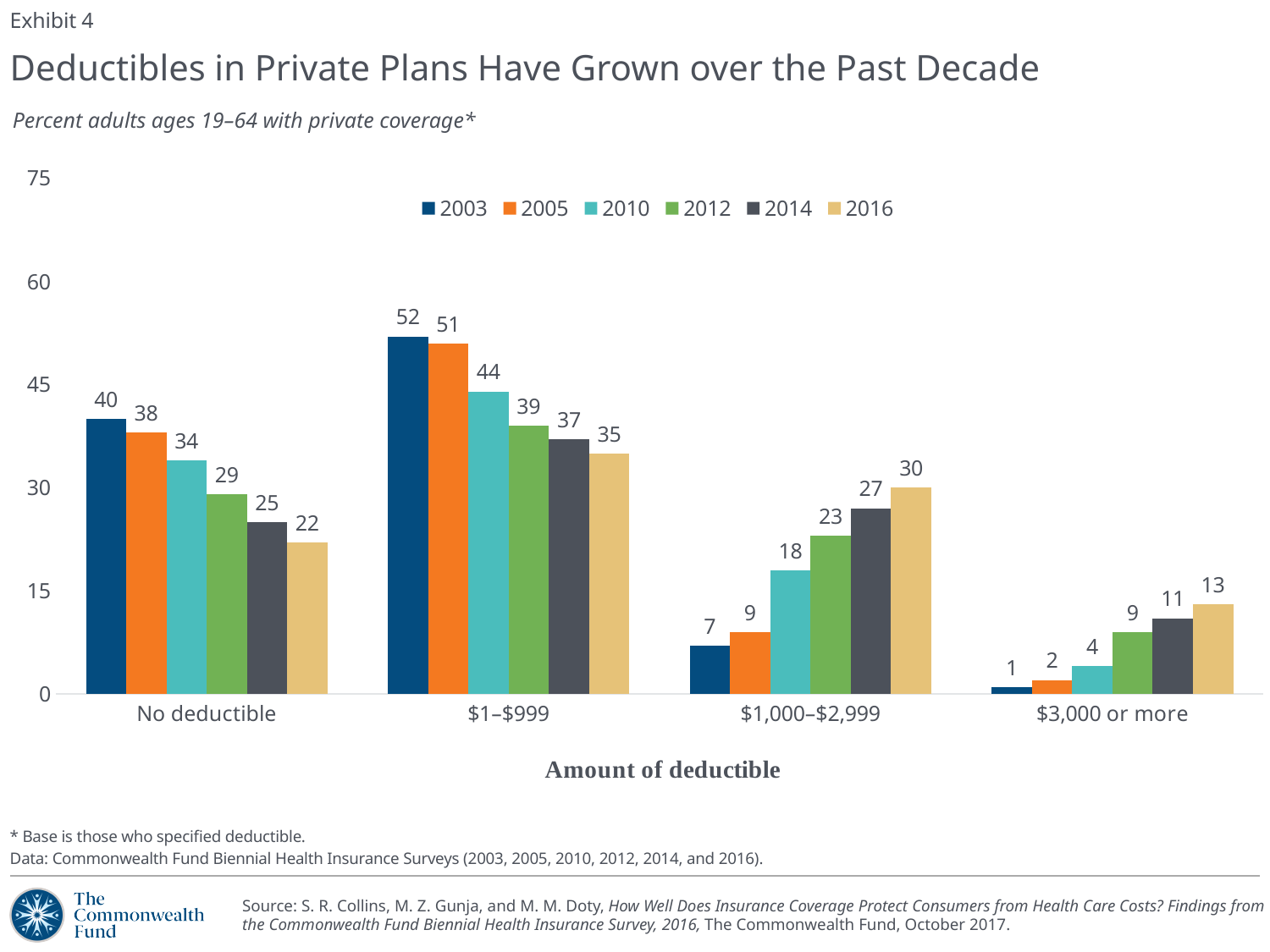
Which is larger: the 2014 value for "$1,000–$2,999" or the 2014 value for "No deductible"? 2014 value for "$1,000–$2,999" What is the value for 2003 in the "$1–$999" category? 52 Do the values in the "$3,000 or more" category rise or fall from 2003 to 2016? Rise What is the value for 2016 in the "No deductible" category? 22 How many series does the legend list? 6 Which year has the highest value in the "$3,000 or more" category? 2016 What is the x-axis title of the chart? Amount of deductible What is the value for 2010 in the "$1,000–$2,999" category? 18 How many deductible categories are shown on the x axis? 4 Which year has the lowest value in the "No deductible" category? 2016 What is the difference between the 2003 and 2016 values in the "$1–$999" category? 17 What kind of chart is shown on the slide? Bar chart